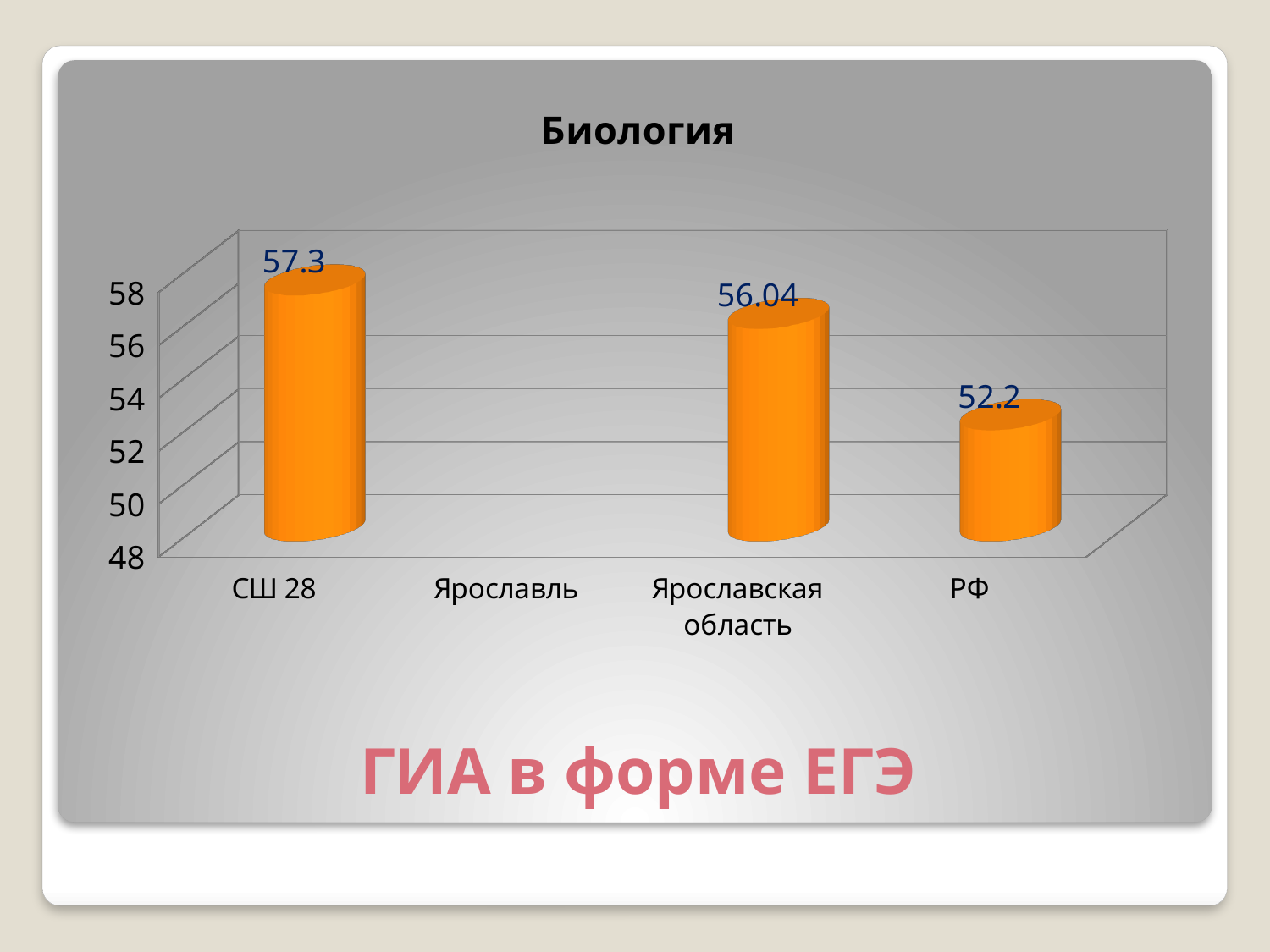
What is the difference between the values for СШ 28 and РФ? 5.1 What is the value for СШ 28? 57.3 What is the difference between the values for Ярославская область and РФ? 3.84 How many bars are plotted on the chart? 3 What is the title of the chart? Биология What is the value for Ярославская область? 56.04 Which is larger, the value for СШ 28 or the value for Ярославская область? СШ 28 What is the value for РФ? 52.2 Which category has the lowest plotted value? РФ What kind of chart is shown? bar chart Is the value for РФ greater or less than 54? less Which category has the highest value? СШ 28